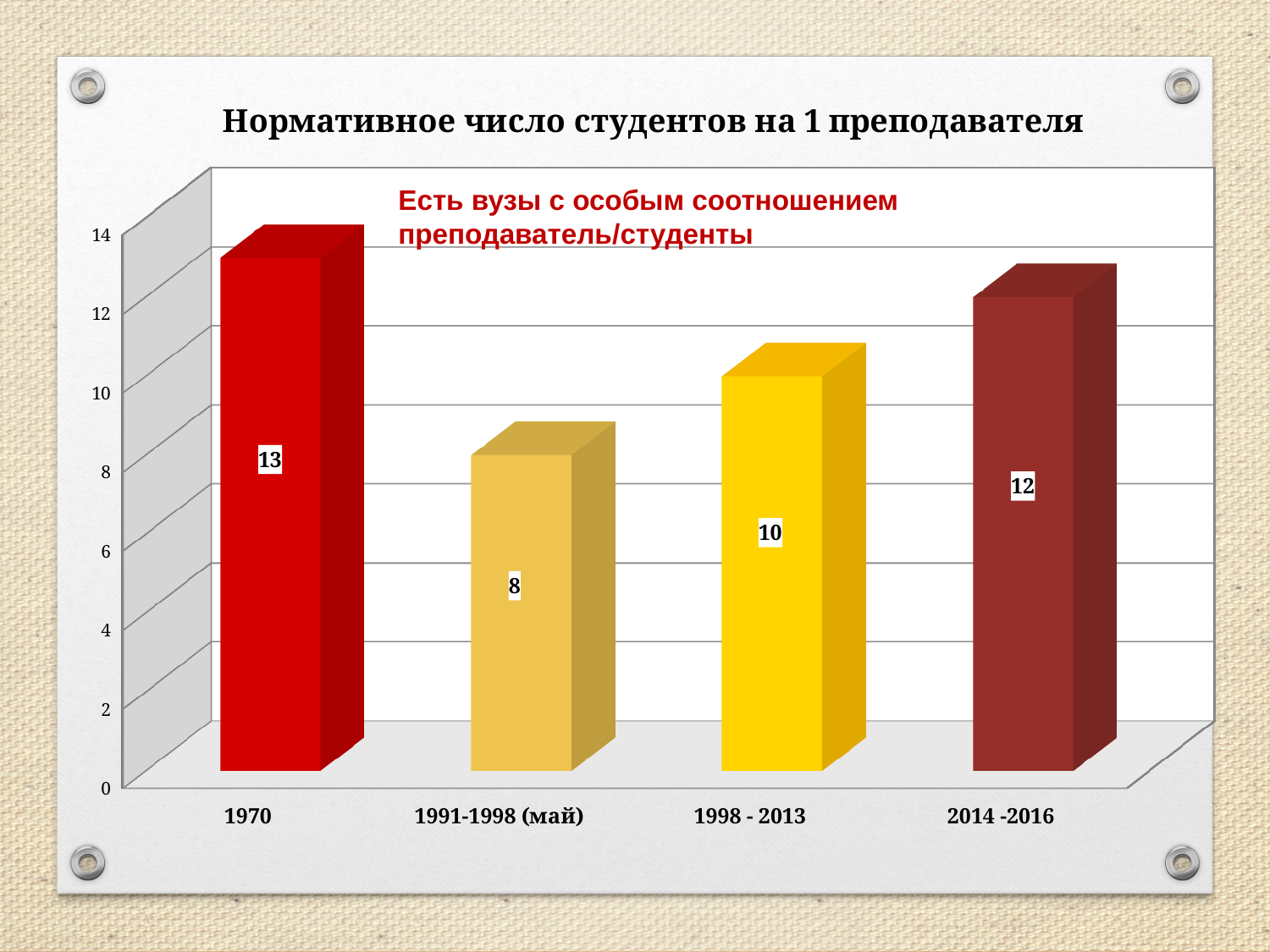
What is the difference between the values for 2014 -2016 and 1998 - 2013? 2 How many categories are shown on the x axis? 4 Which category has the lowest value? 1991-1998 (май) What is the value for 1991-1998 (май)? 8 What kind of chart is shown on the slide? bar chart What is the value for 1998 - 2013? 10 What is the title of the chart? Нормативное число студентов на 1 преподавателя Which is larger, the value for 1998 - 2013 or the value for 2014 -2016? 2014 -2016 What is the difference between the values for 1970 and 1991-1998 (май)? 5 What is the value for 1970? 13 What is the value for 2014 -2016? 12 Which category has the highest value? 1970